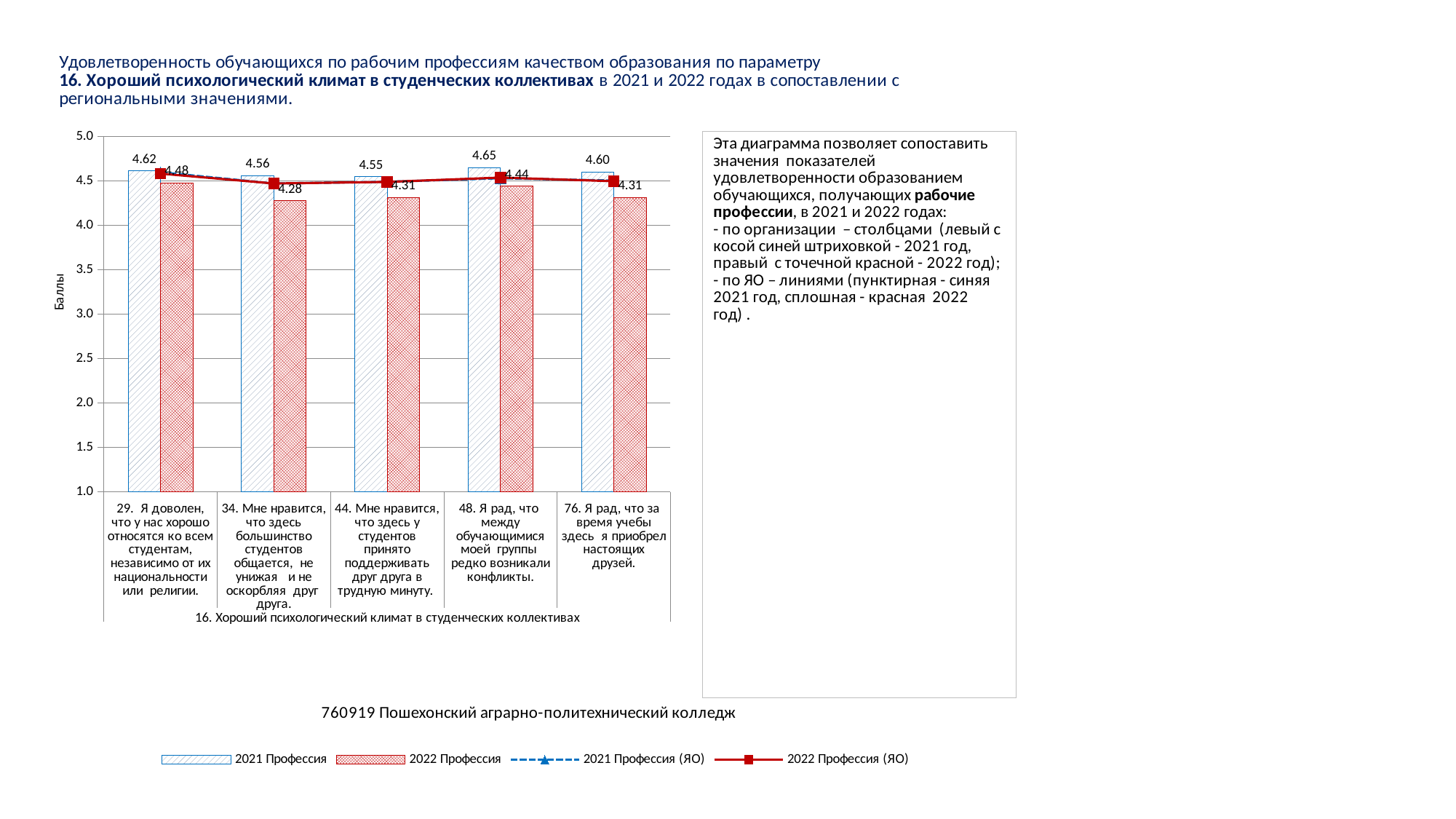
Which is larger for category "29. Я доволен, что у нас хорошо относятся ко всем студентам, независимо от их национальности или религии.": the 2021 Профессия value or the 2022 Профессия value? 2021 Профессия What is the 2022 Профессия value for category "34. Мне нравится, что здесь большинство студентов общается, не унижая и не оскорбляя друг друга."? 4.28 What is the 2022 Профессия value for category "48. Я рад, что между обучающимися моей группы редко возникали конфликты."? 4.44 What is the difference between the 2021 Профессия and 2022 Профессия values for category "44. Мне нравится, что здесь у студентов принято поддерживать друг друга в трудную минуту."? 0.24 Is the 2022 Профессия value for category "34. Мне нравится, что здесь большинство студентов общается, не унижая и не оскорбляя друг друга." greater or less than 4.5? less How many categories are shown on the x axis of the chart? 5 Which category has the highest 2021 Профессия value? 48. Я рад, что между обучающимися моей группы редко возникали конфликты. How many series does the chart legend list? 4 What is the 2021 Профессия value for category "76. Я рад, что за время учебы здесь я приобрел настоящих друзей."? 4.60 Which category has the lowest 2022 Профессия value? 34. Мне нравится, что здесь большинство студентов общается, не унижая и не оскорбляя друг друга. What is the 2021 Профессия value for category "29. Я доволен, что у нас хорошо относятся ко всем студентам, независимо от их национальности или религии."? 4.62 What is the label of the vertical axis of the chart? Баллы